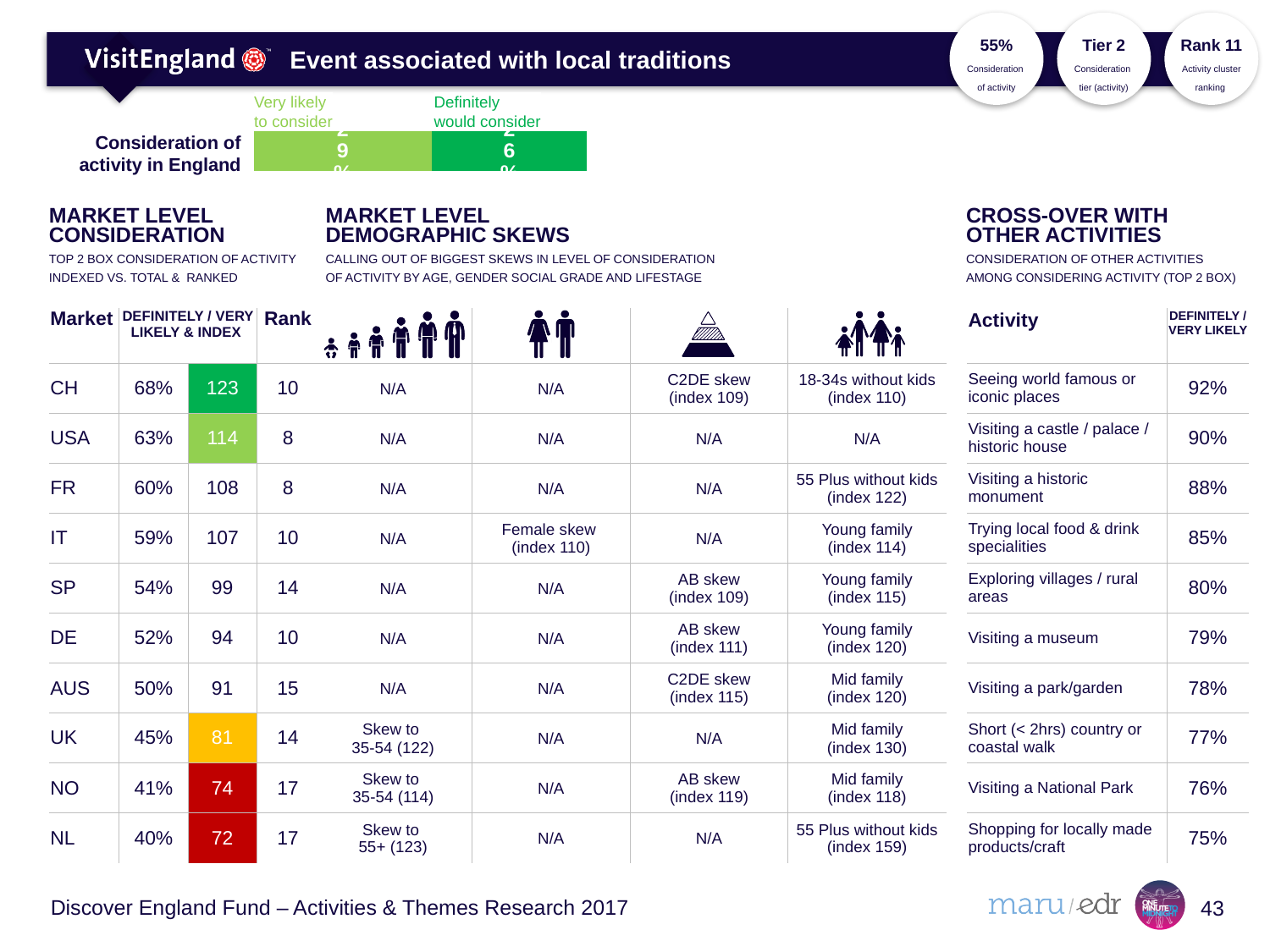
In the 'Consideration of activity in England' bar chart, which segment is larger: 'Very likely to consider' or 'Definitely would consider'? Very likely to consider In the 'Consideration of activity in England' bar chart, what is the value for 'Very likely to consider'? 29% In the 'Consideration of activity in England' bar chart, what is the value for 'Definitely would consider'? 26% What is the category label to the left of the stacked bar chart? Consideration of activity in England In the 'Consideration of activity in England' bar chart, what is the difference between 'Very likely to consider' and 'Definitely would consider'? 3 percentage points What kind of chart is shown under the title 'Event associated with local traditions'? Stacked bar chart How many series does the legend of the 'Consideration of activity in England' bar chart list? 2 In the 'Consideration of activity in England' bar chart, which series is shown in the darker green? Definitely would consider What is the total of the stacked bar for 'Consideration of activity in England'? 55% How many bars are plotted in the 'Consideration of activity in England' chart? 1